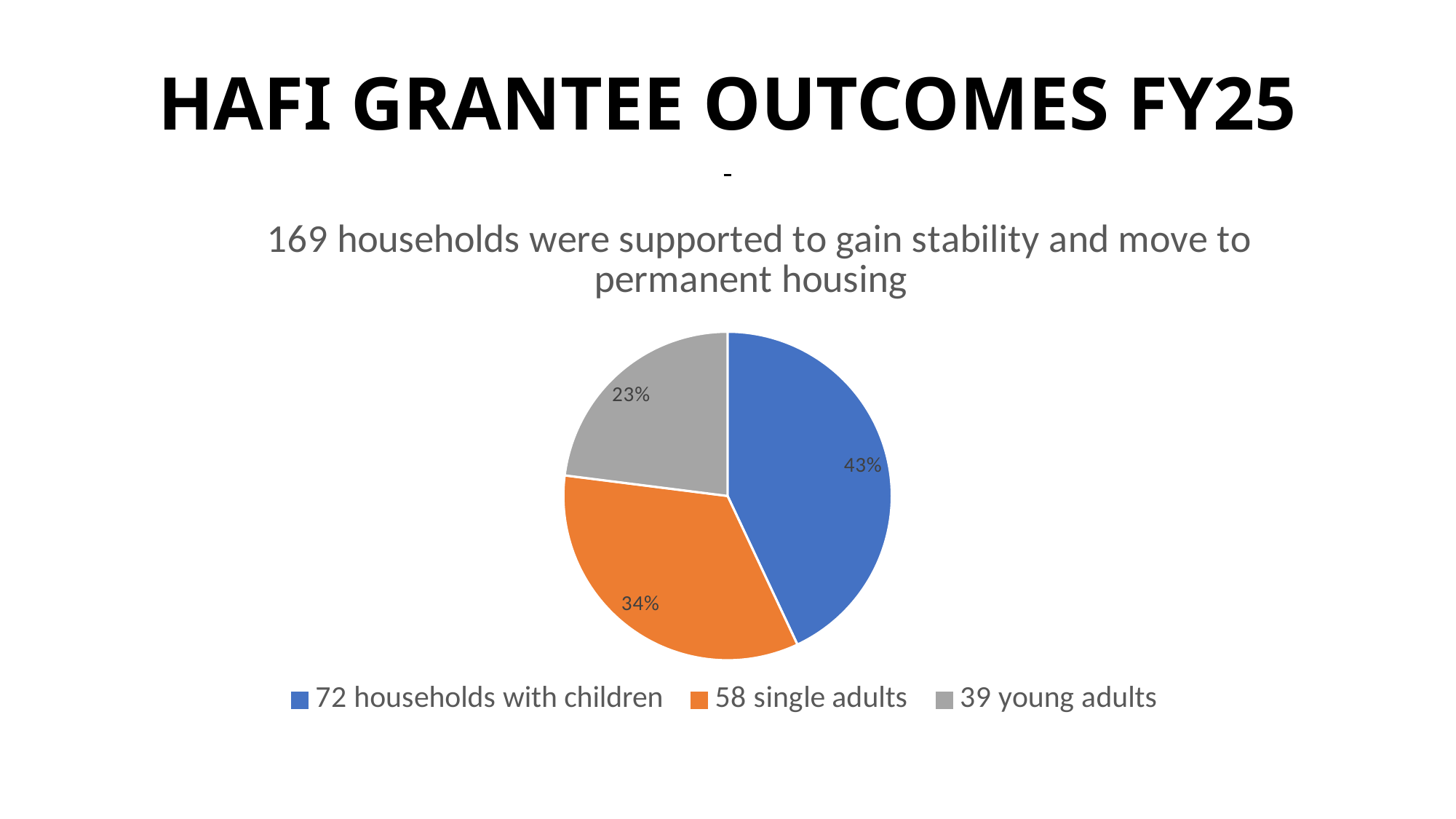
What kind of chart is shown on the slide? pie chart What percentage of the pie is labelled for the '72 households with children' slice? 43% What percentage is shown for the '58 single adults' slice? 34% What is the difference in percentage points between the '72 households with children' slice and the '39 young adults' slice? 20 Which slice of the pie is the largest? 72 households with children What colour is the '58 single adults' slice? orange What percentage is shown for the '39 young adults' slice? 23% How many slices does the pie chart have? 3 What is the title of the chart? 169 households were supported to gain stability and move to permanent housing Which slice of the pie is the smallest? 39 young adults Which is larger, the '58 single adults' slice or the '39 young adults' slice? 58 single adults How many entries does the legend list? 3